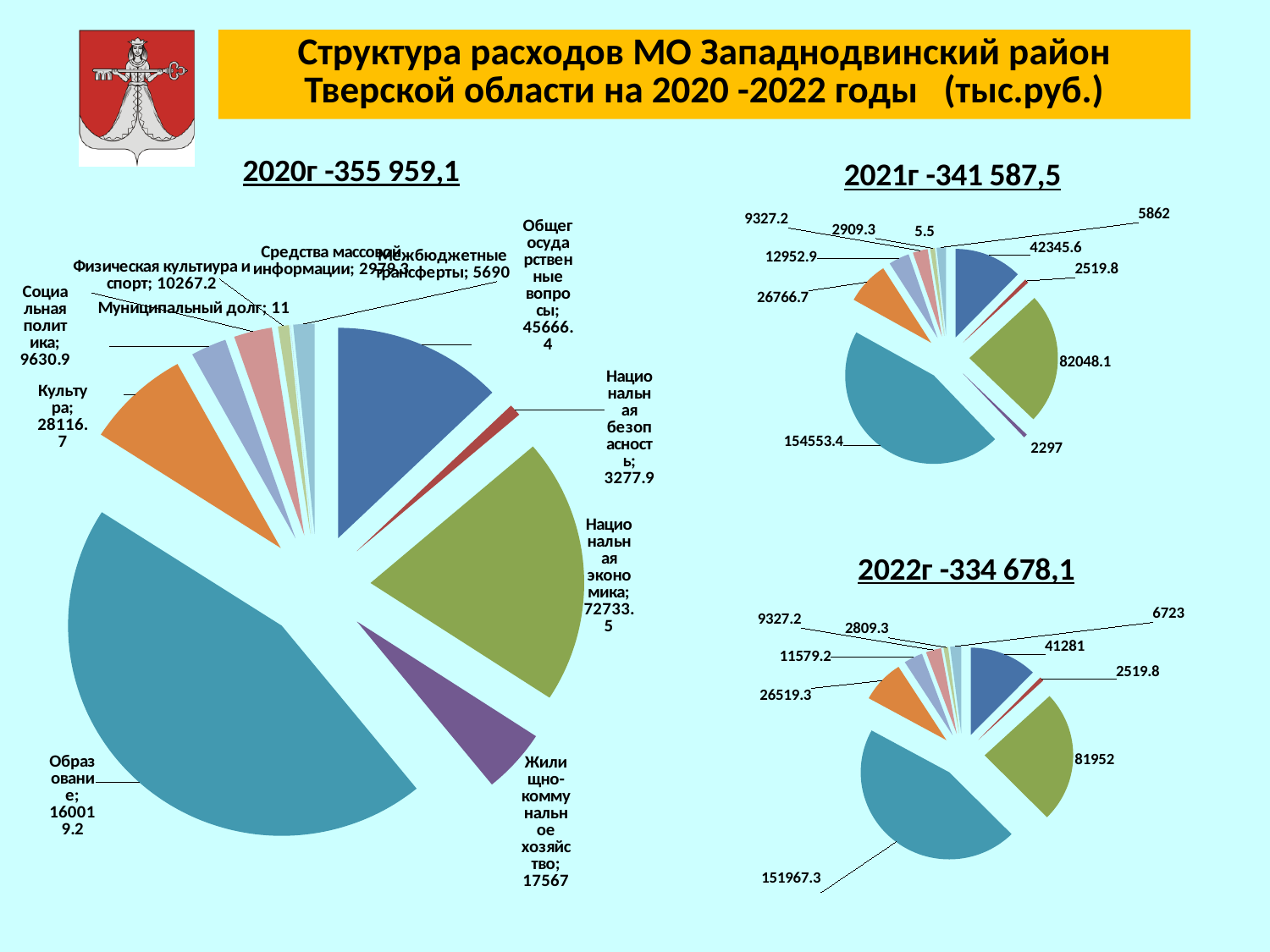
In the 2021 chart, what is the value of the largest slice? 154553.4 What kind of chart is used on this slide for the 2020 expenditure structure? pie chart In the 2021 chart, what is the difference between the two largest slices (154553.4 and 82048.1)? 72505.3 In the 2020 chart, what is the value for Национальная экономика? 72733.5 In the 2020 chart, what is the value for Жилищно-коммунальное хозяйство? 17567 In the 2020 chart, which is larger: Общегосударственные вопросы or Культура? Общегосударственные вопросы In the 2020 chart, what is the difference between Культура and Социальная политика? 18485.8 In the 2020 chart, which category has the largest value? Образование In the 2020 chart, which category has the smallest value? Муниципальный долг What total is given in the heading of the 2022 chart? 334 678,1 How many categories are shown in the 2020 chart? 11 In the 2020 chart, what is the value for Образование? 160019.2